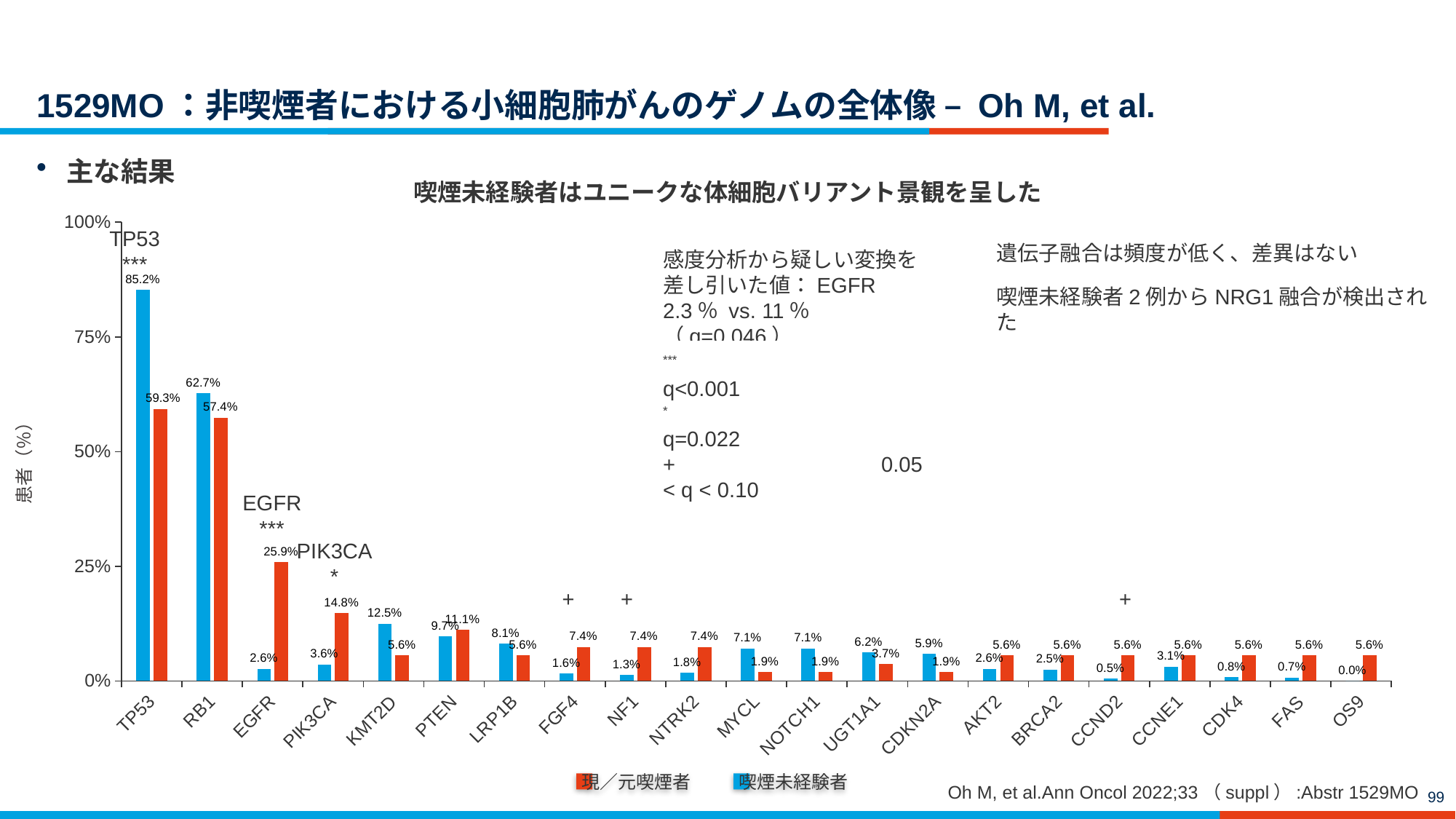
Which colour represents the 現／元喫煙者 series? Red What is the difference between the 喫煙未経験者 and 現／元喫煙者 values for TP53? 25.9% Is the value for RB1 in the 喫煙未経験者 series greater or less than 50%? greater How many genes are shown on the x axis? 21 Which gene has the lowest value in the 喫煙未経験者 series? OS9 What is the value for EGFR in the 現／元喫煙者 series? 25.9% For PIK3CA, which series has the larger value, 現／元喫煙者 or 喫煙未経験者? 現／元喫煙者 What is the value for OS9 in the 喫煙未経験者 series? 0.0% How many series does the legend list? 2 What is the value for TP53 in the 喫煙未経験者 series? 85.2% What kind of chart is shown on the slide? Bar chart Which gene has the highest value in the 喫煙未経験者 series? TP53